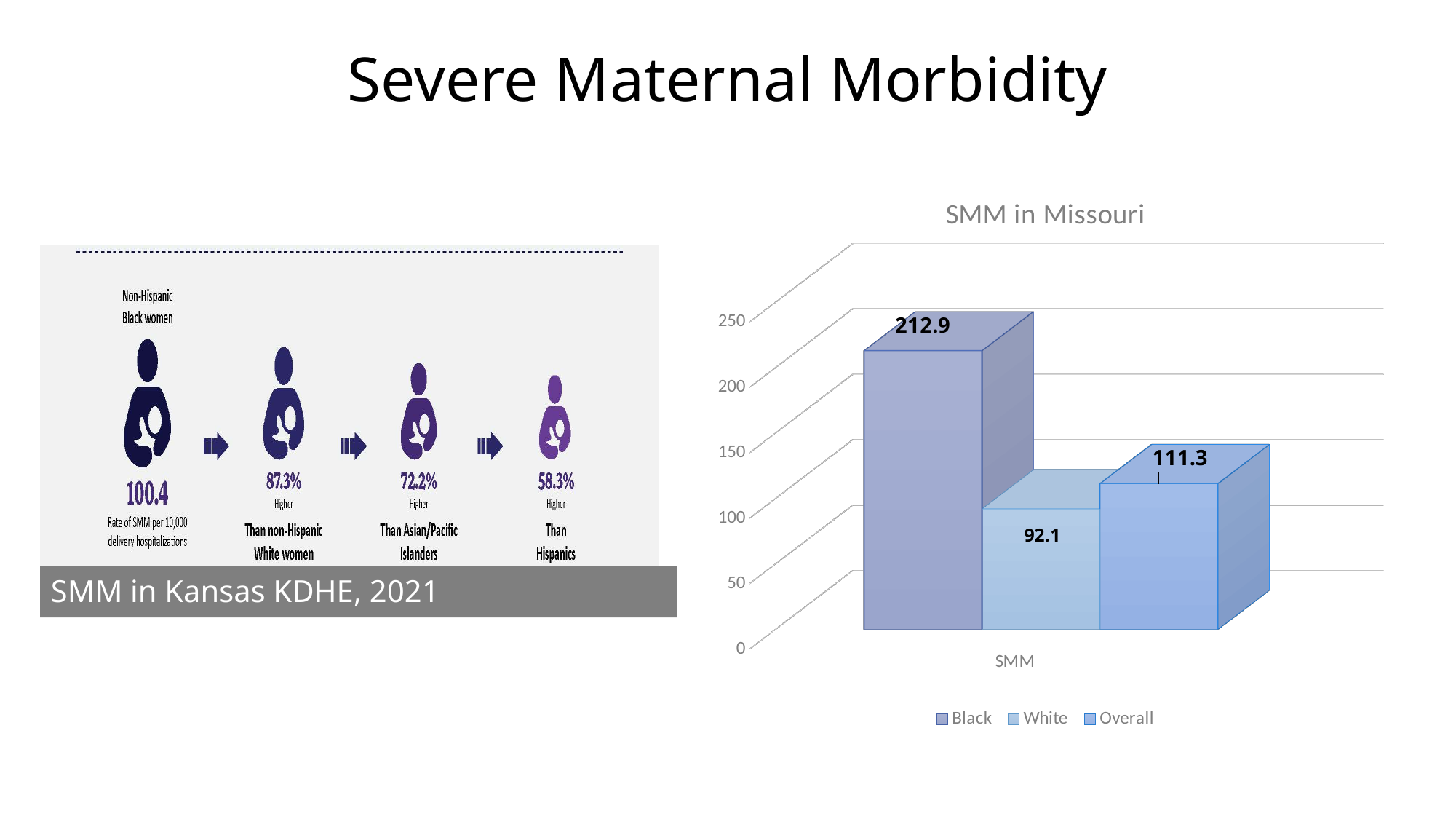
What kind of chart is the SMM in Missouri chart? Bar chart How many series does the legend of the SMM in Missouri chart list? 3 In the SMM in Missouri chart, what is the value for Overall? 111.3 In the SMM in Missouri chart, which is larger, the value for Overall or the value for White? Overall In the SMM in Missouri chart, which series has the lowest value? White In the SMM in Missouri chart, what is the difference between the Overall and White values? 19.2 In the SMM in Missouri chart, what is the value for White? 92.1 In the SMM in Missouri chart, which series has the highest value? Black What is the title of the chart on the right side of the slide? SMM in Missouri In the SMM in Missouri chart, what is the value for Black? 212.9 In the SMM in Missouri chart, what is the difference between the Black and White values? 120.8 In the SMM in Missouri chart, is the value for Black greater or less than 200? greater